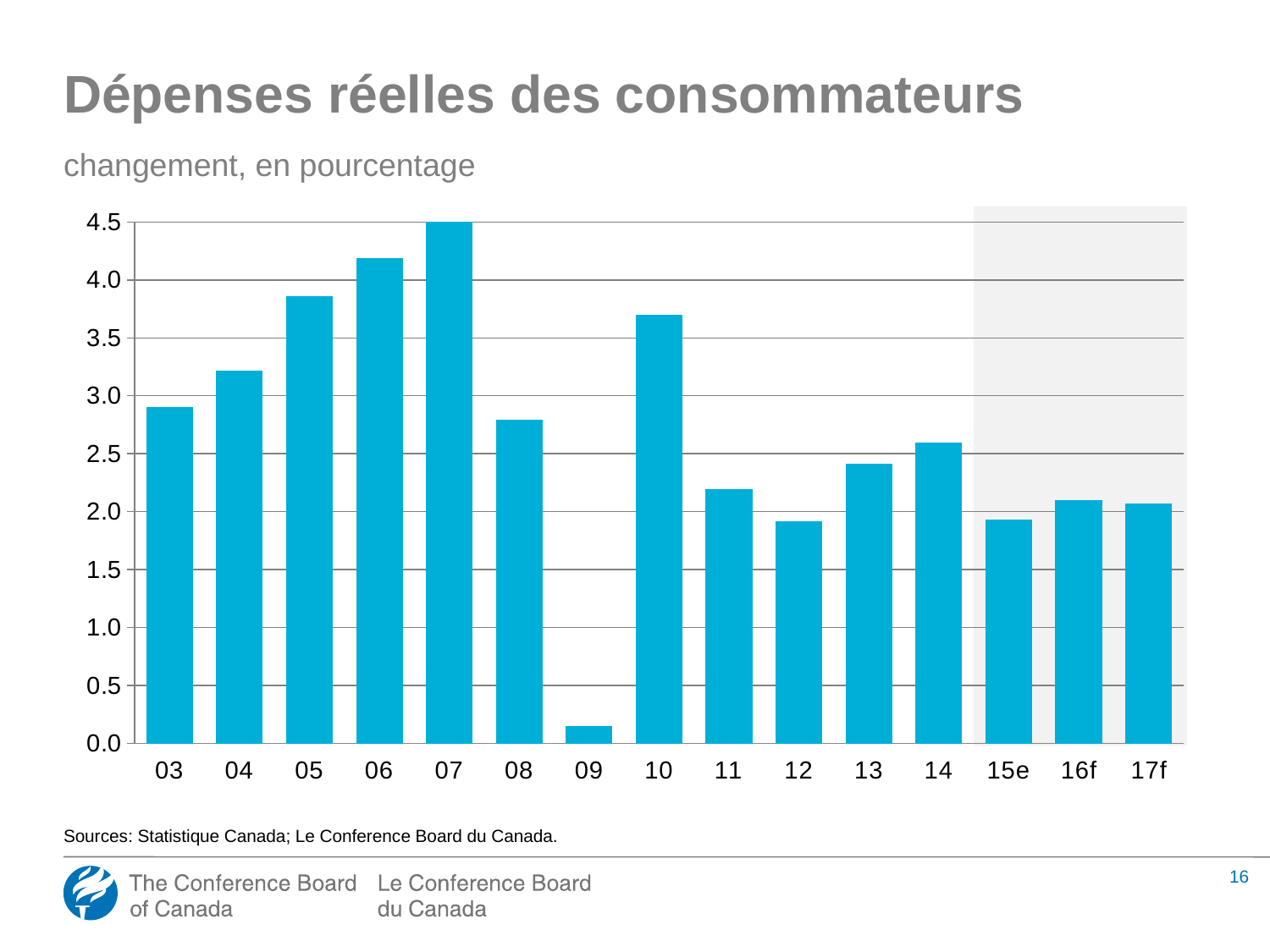
Is the value for 10 greater or less than 3.5? greater What is the title of the chart on the slide? Dépenses réelles des consommateurs How many bars (years) are plotted in the chart? 15 What kind of chart is shown on the slide? bar chart Is the value for 09 greater or less than 0.5? less Which year has the highest value in the chart? 07 Is the value for 06 greater or less than 4.0? greater Which is larger, the value for 14 or the value for 11? 14 Which year has the lowest value in the chart? 09 Do the values rise or fall from 03 to 07? rise Which is larger, the value for 05 or the value for 08? 05